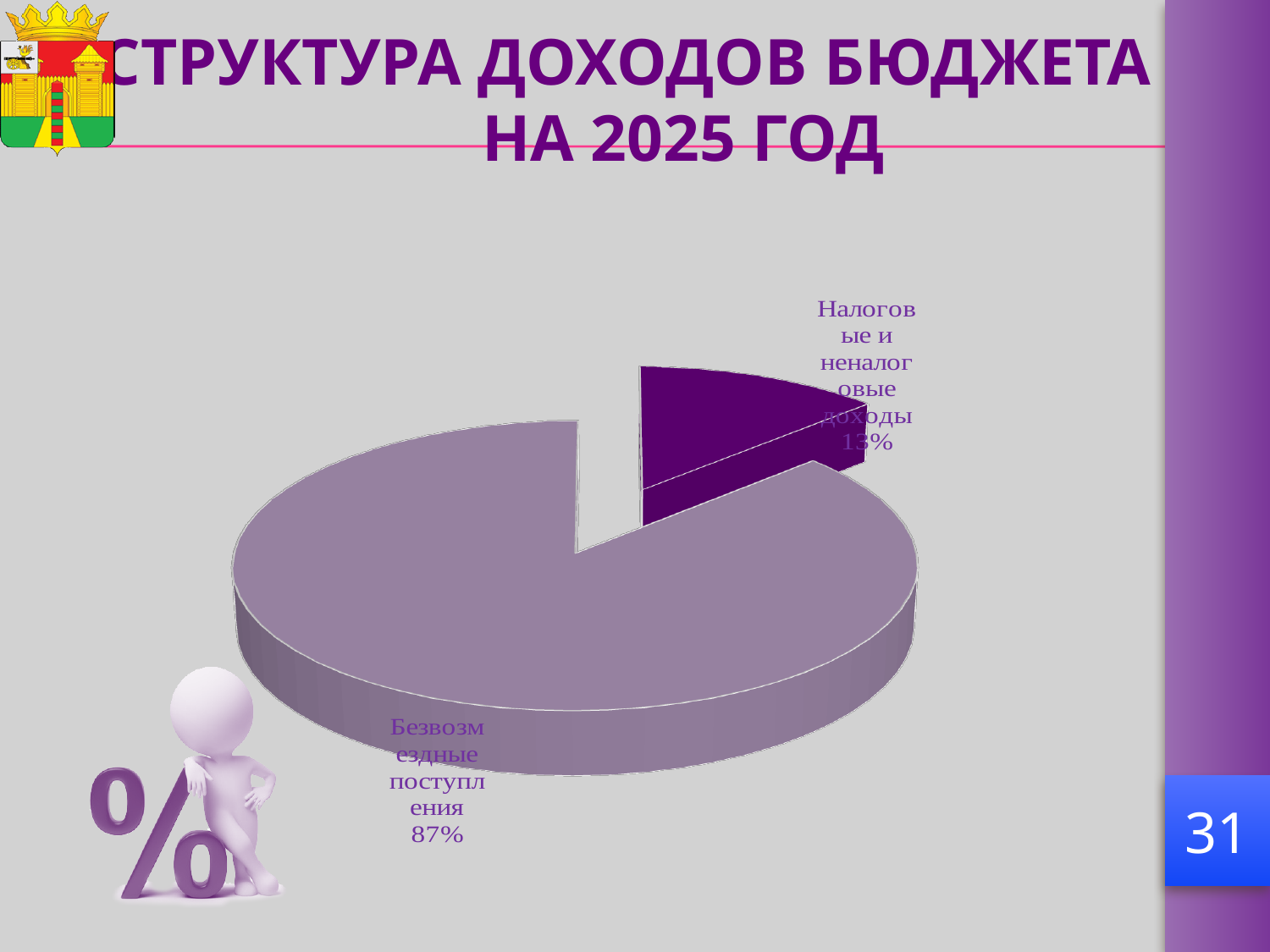
How many slices does the pie chart have? 2 What is the difference in percentage points between the "Безвозмездные поступления" slice and the "Налоговые и неналоговые доходы" slice? 74 Is the share for "Безвозмездные поступления" greater or less than 50%? greater Which slice of the pie chart is the largest? Безвозмездные поступления Which is larger: the share for "Безвозмездные поступления" or the share for "Налоговые и неналоговые доходы"? Безвозмездные поступления Which slice of the pie chart is pulled out (exploded) from the rest of the pie? Налоговые и неналоговые доходы What kind of chart is shown on the slide? Pie chart What share of the pie does "Безвозмездные поступления" take? 87% Which slice of the pie chart is the smallest? Налоговые и неналоговые доходы What share of the pie does "Налоговые и неналоговые доходы" take? 13% What is the title of the slide containing the pie chart? СТРУКТУРА ДОХОДОВ БЮДЖЕТА НА 2025 ГОД